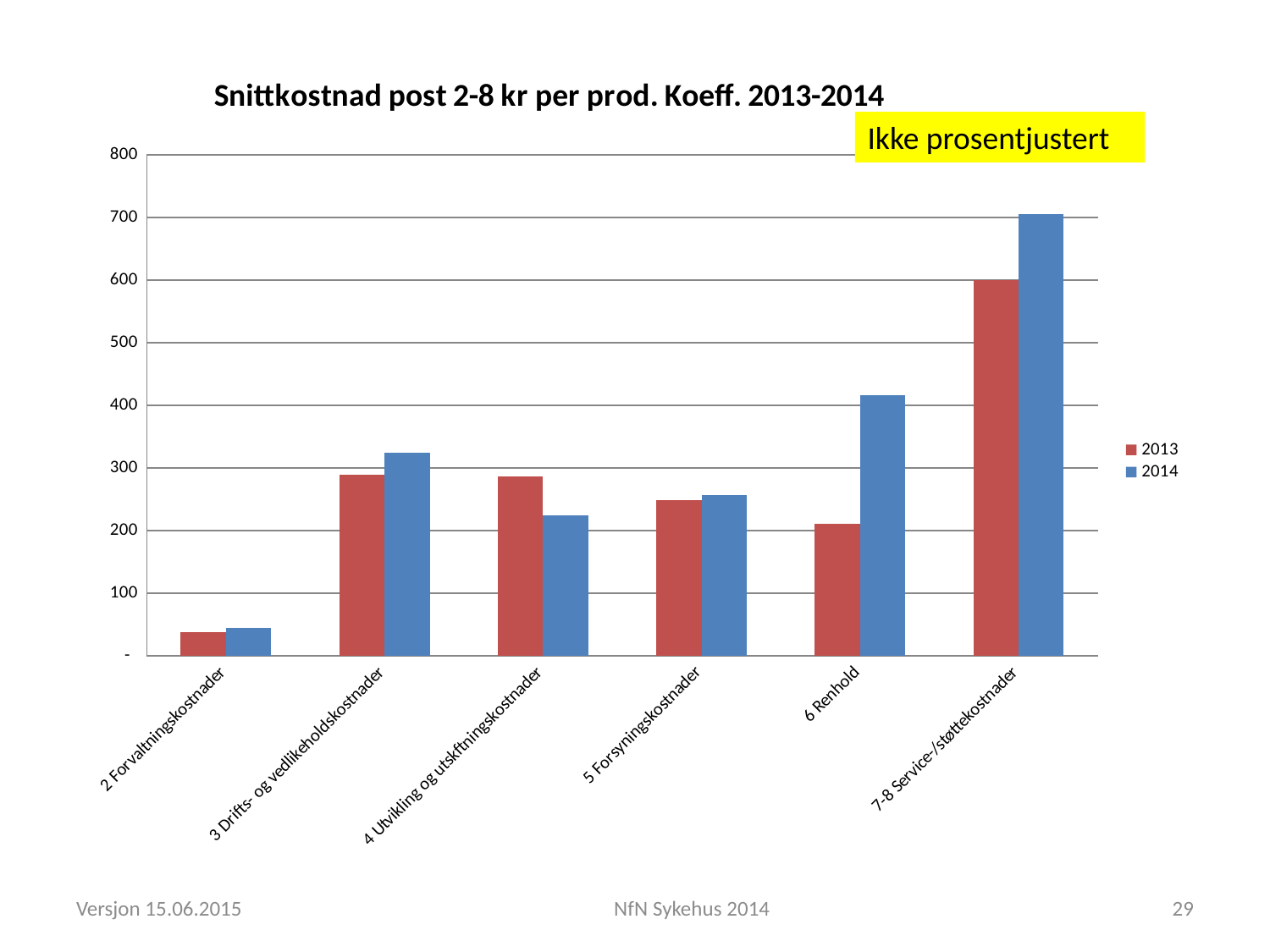
What kind of chart is shown on the slide? bar chart How many series does the legend list? 2 Is the 2014 value for 3 Drifts- og vedlikeholdskostnader greater or less than 300? greater Which category has the lowest 2013 value? 2 Forvaltningskostnader Is the 2014 value for 4 Utvikling og utskiftningskostnader greater or less than 300? less Is the 2013 value for 2 Forvaltningskostnader greater or less than 100? less For 4 Utvikling og utskiftningskostnader, which year has the larger value, 2013 or 2014? 2013 What is the title of the chart? Snittkostnad post 2-8 kr per prod. Koeff. 2013-2014 How many categories are shown on the x axis? 6 For 6 Renhold, which year has the larger value, 2013 or 2014? 2014 Which category has the highest 2014 value? 7-8 Service-/støttekostnader